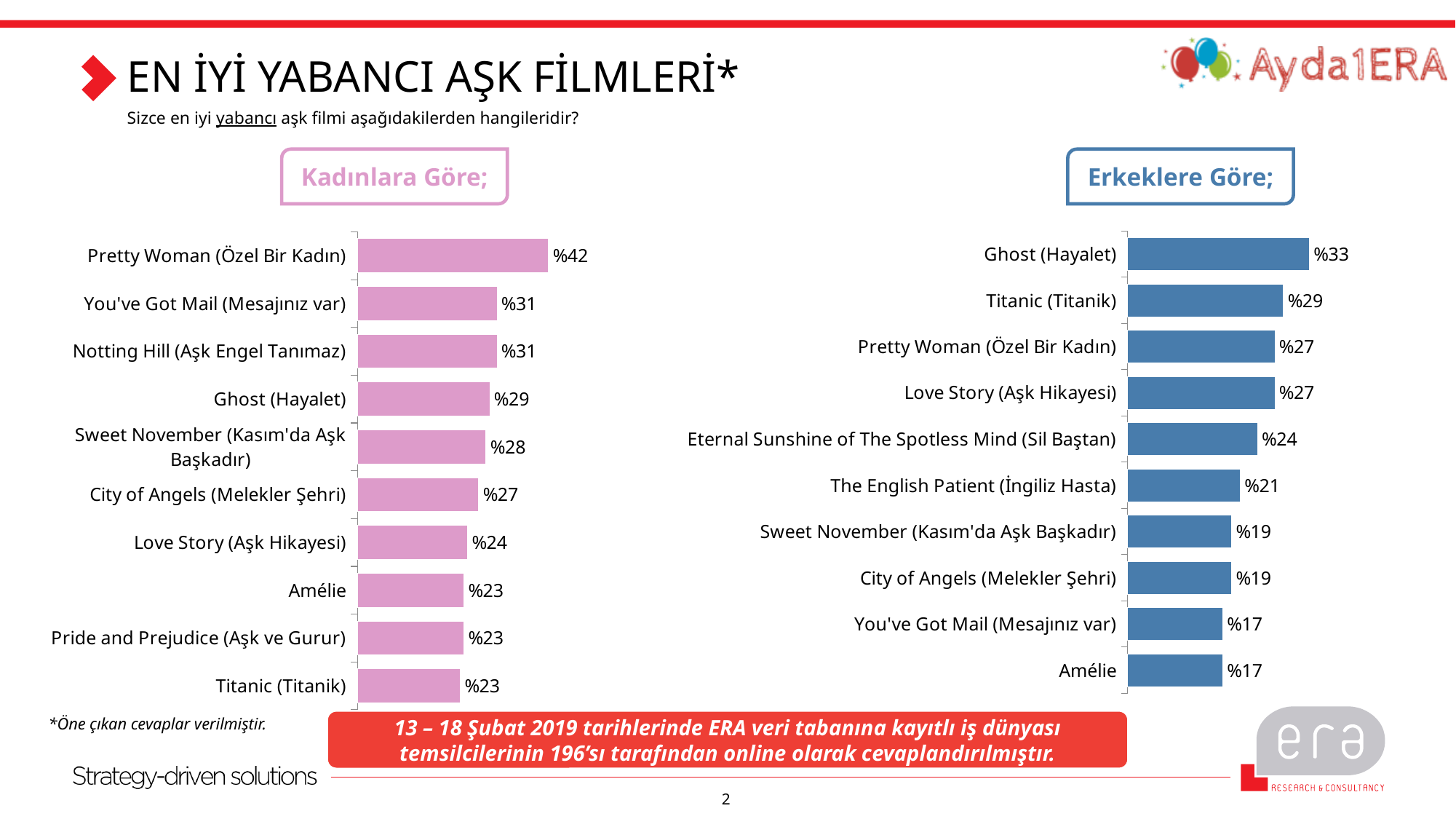
In the "Kadınlara Göre;" chart, what is the value for Pretty Woman (Özel Bir Kadın)? %42 What colour are the bars in the "Kadınlara Göre;" chart? Pink In the "Erkeklere Göre;" chart, which film has the highest value? Ghost (Hayalet) In the "Kadınlara Göre;" chart, which is larger: the value for Titanic (Titanik) or the value for Ghost (Hayalet)? Ghost (Hayalet) In the "Erkeklere Göre;" chart, what is the value for The English Patient (İngiliz Hasta)? %21 In the "Kadınlara Göre;" chart, what is the difference between the values for Pretty Woman (Özel Bir Kadın) and Ghost (Hayalet)? 13 percentage points In the "Erkeklere Göre;" chart, what is the difference between the values for Ghost (Hayalet) and Amélie? 16 percentage points How many films are listed in the "Kadınlara Göre;" chart? 10 In the "Erkeklere Göre;" chart, what is the value for Eternal Sunshine of The Spotless Mind (Sil Baştan)? %24 In the "Erkeklere Göre;" chart, which is larger: the value for Titanic (Titanik) or the value for You've Got Mail (Mesajınız var)? Titanic (Titanik) In the "Kadınlara Göre;" chart, which film has the highest value? Pretty Woman (Özel Bir Kadın) What kind of chart is the "Erkeklere Göre;" chart? Bar chart